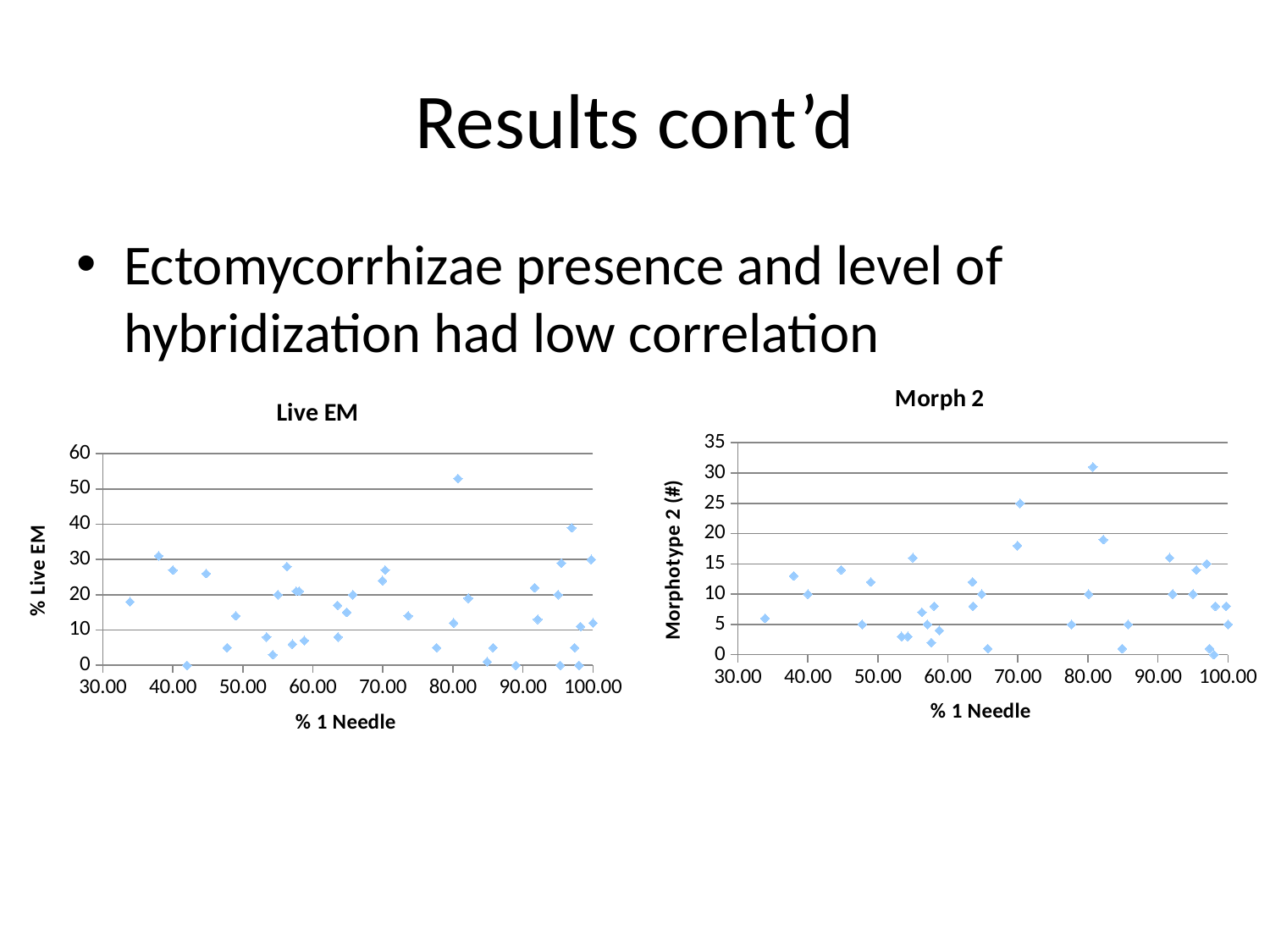
In the 'Live EM' chart, is the highest plotted point greater or less than 50 on the y axis? greater In the 'Morph 2' chart, is the highest plotted point greater or less than 30 on the y axis? greater In the 'Morph 2' chart, what is the smallest tick value shown on the x axis? 30.00 In the 'Morph 2' chart, is the highest plotted point greater or less than 35 on the y axis? less In the 'Live EM' chart, what is the label of the y axis? % Live EM In the 'Live EM' chart, what is the largest tick value shown on the x axis? 100.00 What kind of chart is the 'Live EM' chart on the left? scatter chart What kind of chart is the 'Morph 2' chart on the right? scatter chart